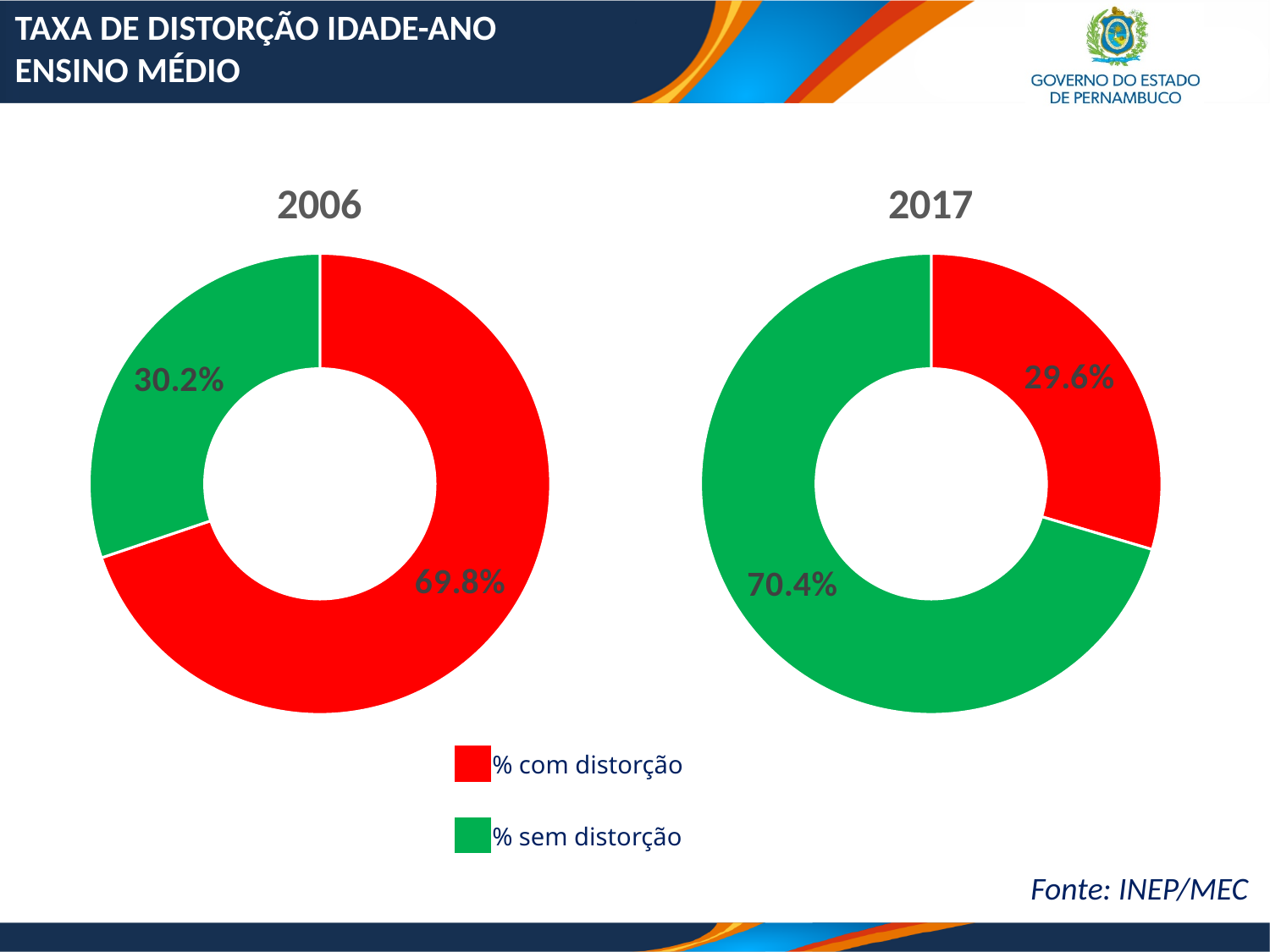
In the 2006 chart, what is the value for "% com distorção"? 69.8% Is the value for "% com distorção" larger in the 2006 chart or the 2017 chart? 2006 How many entries does the legend list? 2 In the 2006 chart, which category has the largest share? % com distorção In the 2017 chart, what is the value for "% sem distorção"? 70.4% How many categories does the 2006 chart show? 2 What type of chart is the 2017 chart? Doughnut chart In the 2006 chart, what is the difference between "% com distorção" and "% sem distorção"? 39.6% In the 2006 chart, what is the value for "% sem distorção"? 30.2% In the 2017 chart, which category has the smallest share? % com distorção Which colour represents "% sem distorção" in the charts? Green In the 2017 chart, what is the value for "% com distorção"? 29.6%